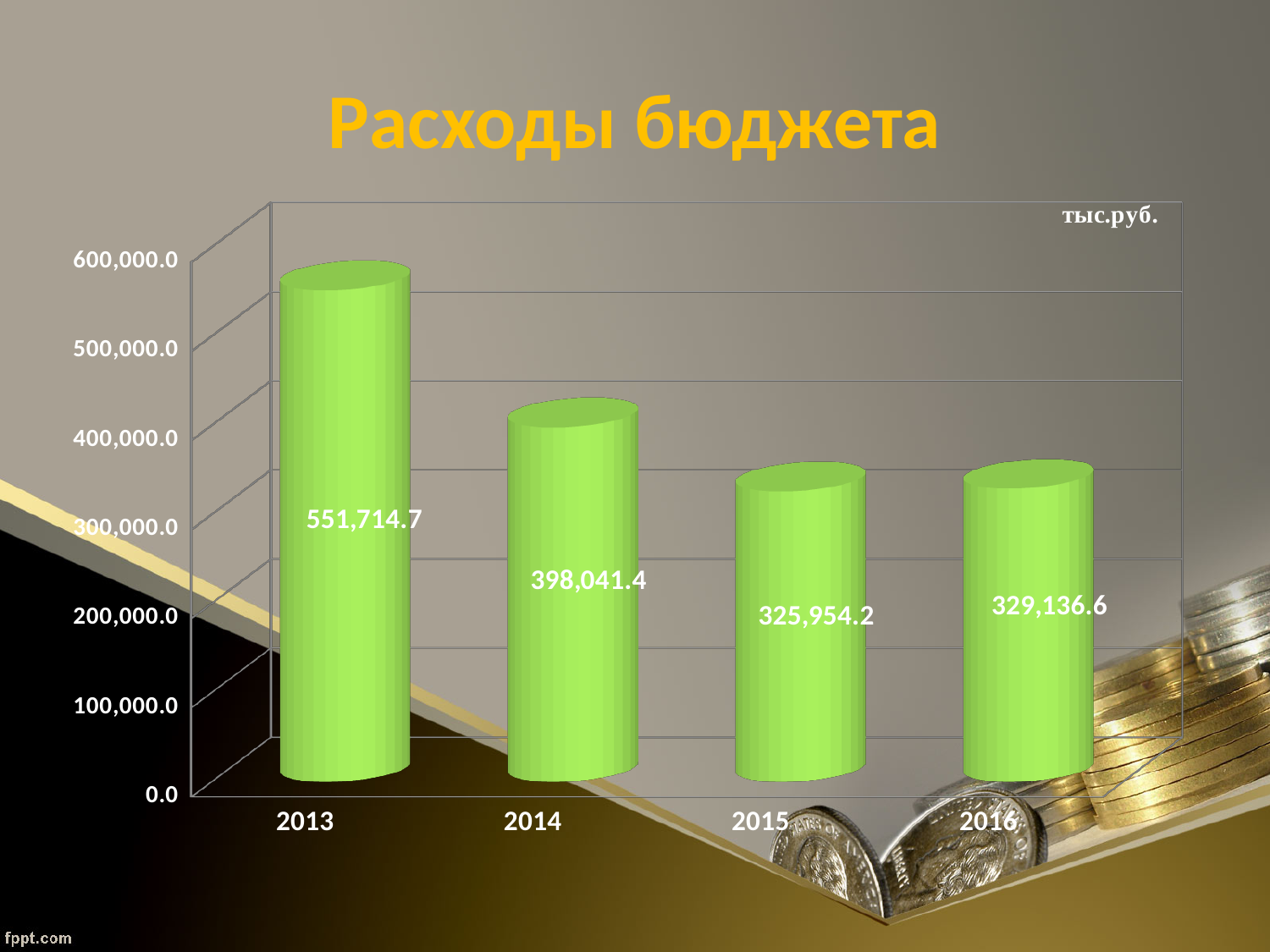
Which year has the highest value? 2013 What is the title of the chart? Расходы бюджета Which year has the lowest value? 2015 What is the value for 2015? 325,954.2 How many years are shown on the chart? 4 What is the value for 2013? 551,714.7 What is the difference between the values for 2013 and 2014? 153,673.3 What is the value for 2016? 329,136.6 What kind of chart is shown on the slide? Bar chart What is the value for 2014? 398,041.4 What is the difference between the values for 2016 and 2015? 3,182.4 Which is larger, the value for 2014 or the value for 2016? 2014